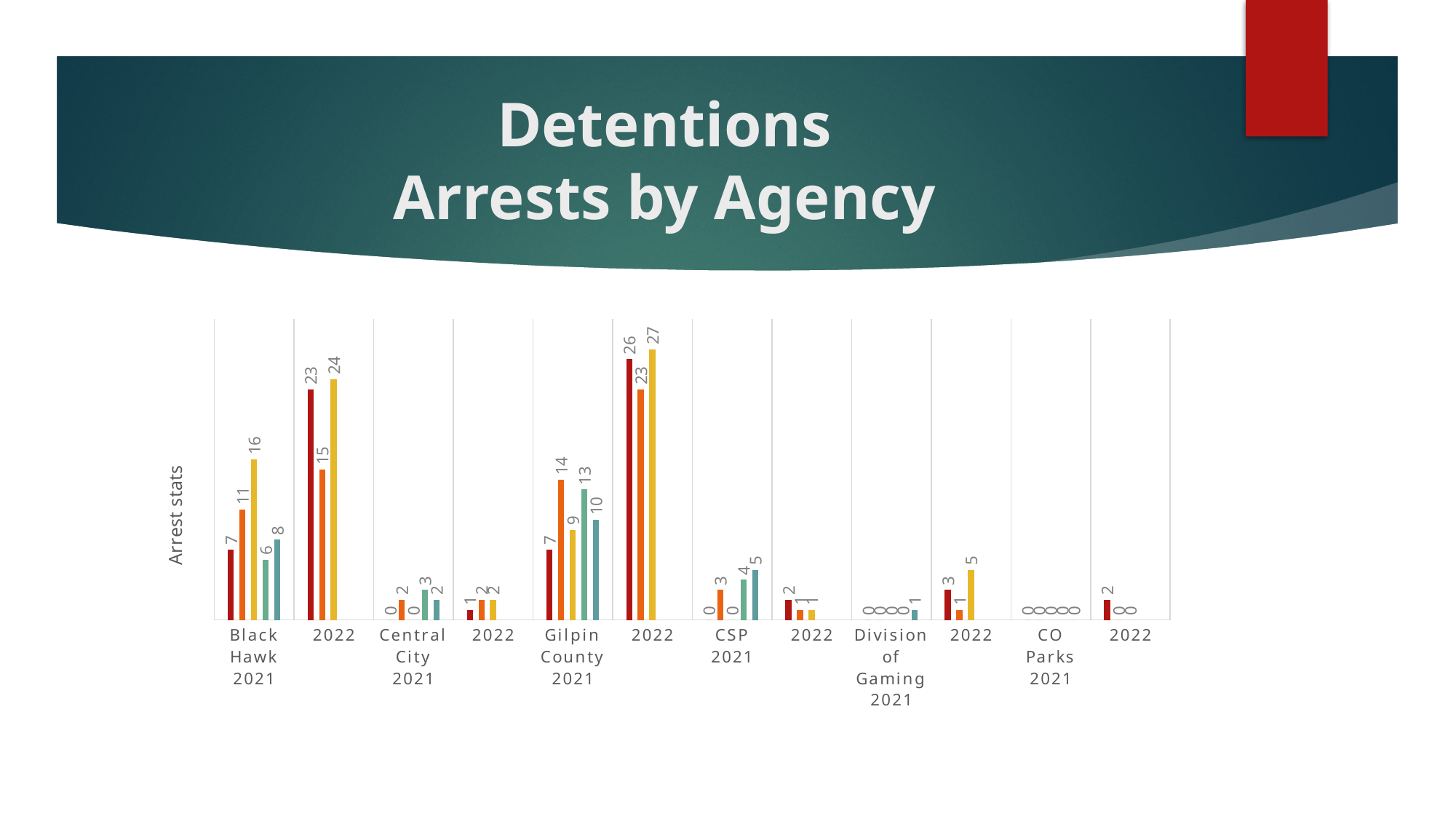
What is the value of the yellow (third) bar for Gilpin County 2022? 27 What is the difference between the yellow bar for Gilpin County 2022 (27) and the yellow bar for Black Hawk 2022 (24)? 3 How many categories are shown along the x axis of the chart? 12 What is the total of the three bars shown for Gilpin County 2022? 76 Which category has all of its bars labelled 0? CO Parks 2021 What is the label on the vertical axis of the chart? Arrest stats What is the total of the five bars shown for Black Hawk 2021? 48 Which is larger: the dark red bar for Black Hawk 2022 or the dark red bar for Gilpin County 2022? Gilpin County 2022 Which category contains the tallest bar in the chart? Gilpin County 2022 What is the value of the dark red (first) bar for Black Hawk 2021? 7 What is the value of the orange (second) bar for Black Hawk 2022? 15 What kind of chart is shown on the slide? bar chart